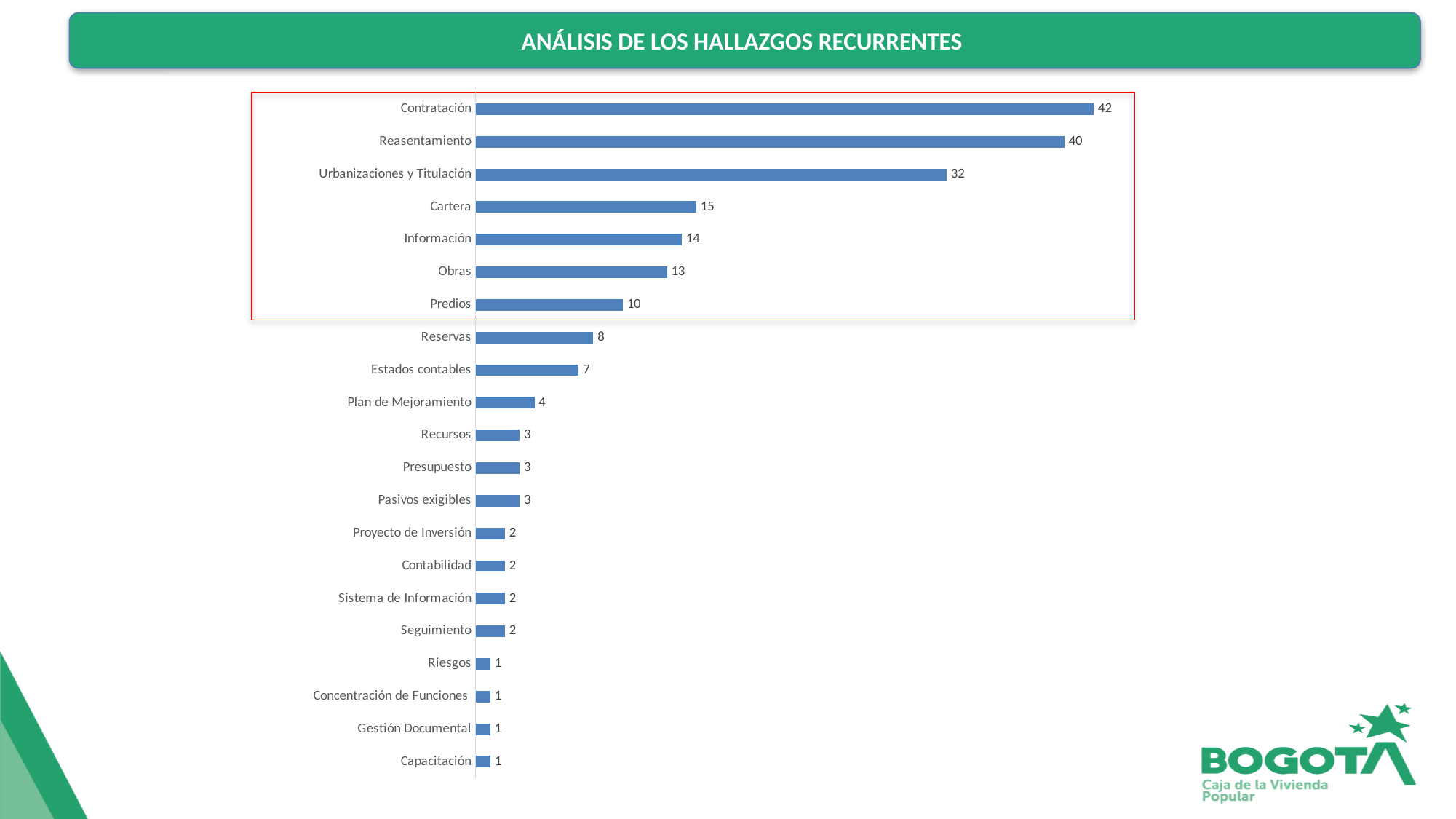
What is the difference between the values for Cartera and Predios? 5 Which is larger, the value for Información or the value for Reservas? Información What kind of chart is shown on the slide? Bar chart What is the value for Obras? 13 What is the value for Estados contables? 7 What is the title shown at the top of the slide? ANÁLISIS DE LOS HALLAZGOS RECURRENTES What is the value for Contratación? 42 What is the value for Plan de Mejoramiento? 4 What is the difference between the values for Contratación and Reasentamiento? 2 Which category has the highest value? Contratación What is the value for Urbanizaciones y Titulación? 32 How many categories are shown in the chart? 21